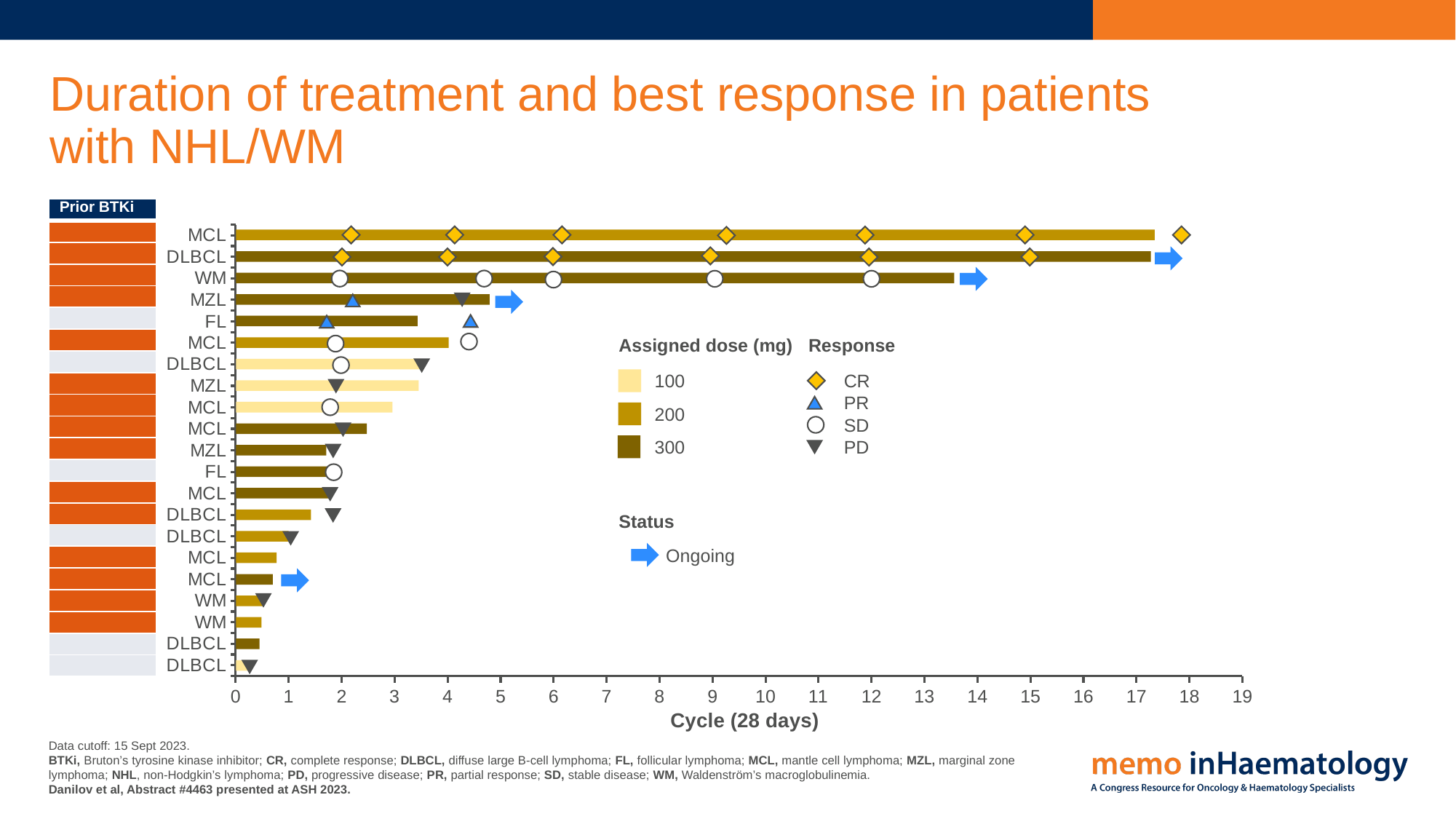
Is the duration of treatment for the WM patient in the third row greater or less than 10 cycles? greater How many patients are marked as ongoing with a blue arrow? 4 Is the duration of treatment for the top MCL patient greater or less than 15 cycles? greater How many response categories does the legend list? 4 How many CR markers are shown on the top MCL patient's bar? 7 How many patients are marked as having received prior BTKi (orange boxes)? 15 Which patient was treated longer, the top MCL patient or the WM patient in the third row? The top MCL patient What kind of chart is shown on the slide? Bar chart How many assigned dose levels does the legend list? 3 What is the title of the x axis? Cycle (28 days)